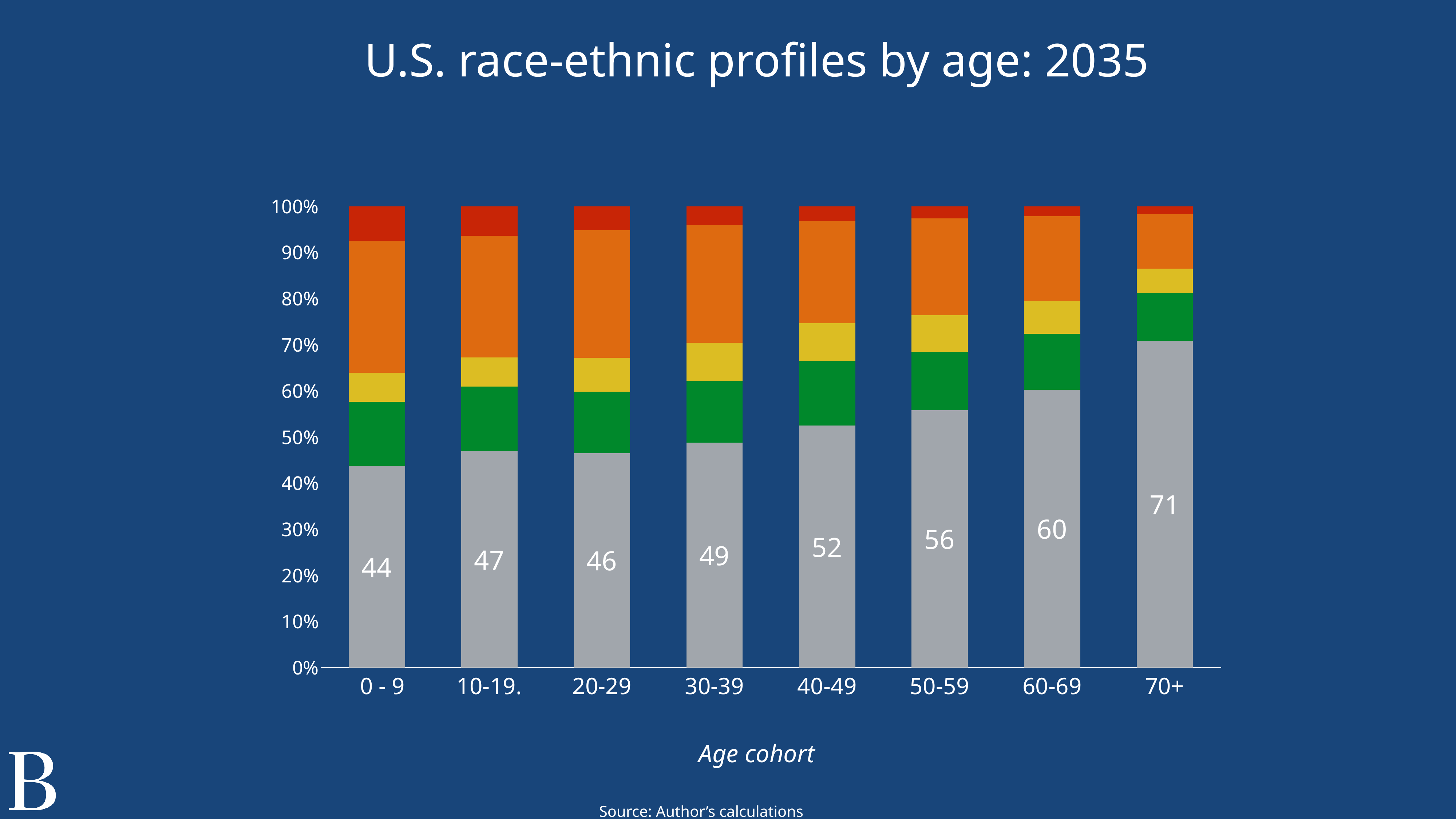
What is the title of the chart? U.S. race-ethnic profiles by age: 2035 Which age cohort has the highest labelled value for the bottom (gray) segment? 70+ What is the label of the x axis? Age cohort What is the labelled value of the bottom (gray) segment for the 40-49 age cohort? 52 How many age cohorts are shown on the x axis? 8 What is the labelled value of the bottom (gray) segment for the 0 - 9 age cohort? 44 What kind of chart is shown on the slide? Stacked bar chart What is the difference between the labelled gray-segment values for the 70+ and 0 - 9 age cohorts? 27 From the 30-39 cohort to the 70+ cohort, do the labelled gray-segment values rise or fall? Rise Which age cohort has the lowest labelled value for the bottom (gray) segment? 0 - 9 What is the labelled value of the bottom (gray) segment for the 70+ age cohort? 71 Which has a larger labelled gray-segment value, the 10-19 cohort or the 20-29 cohort? 10-19